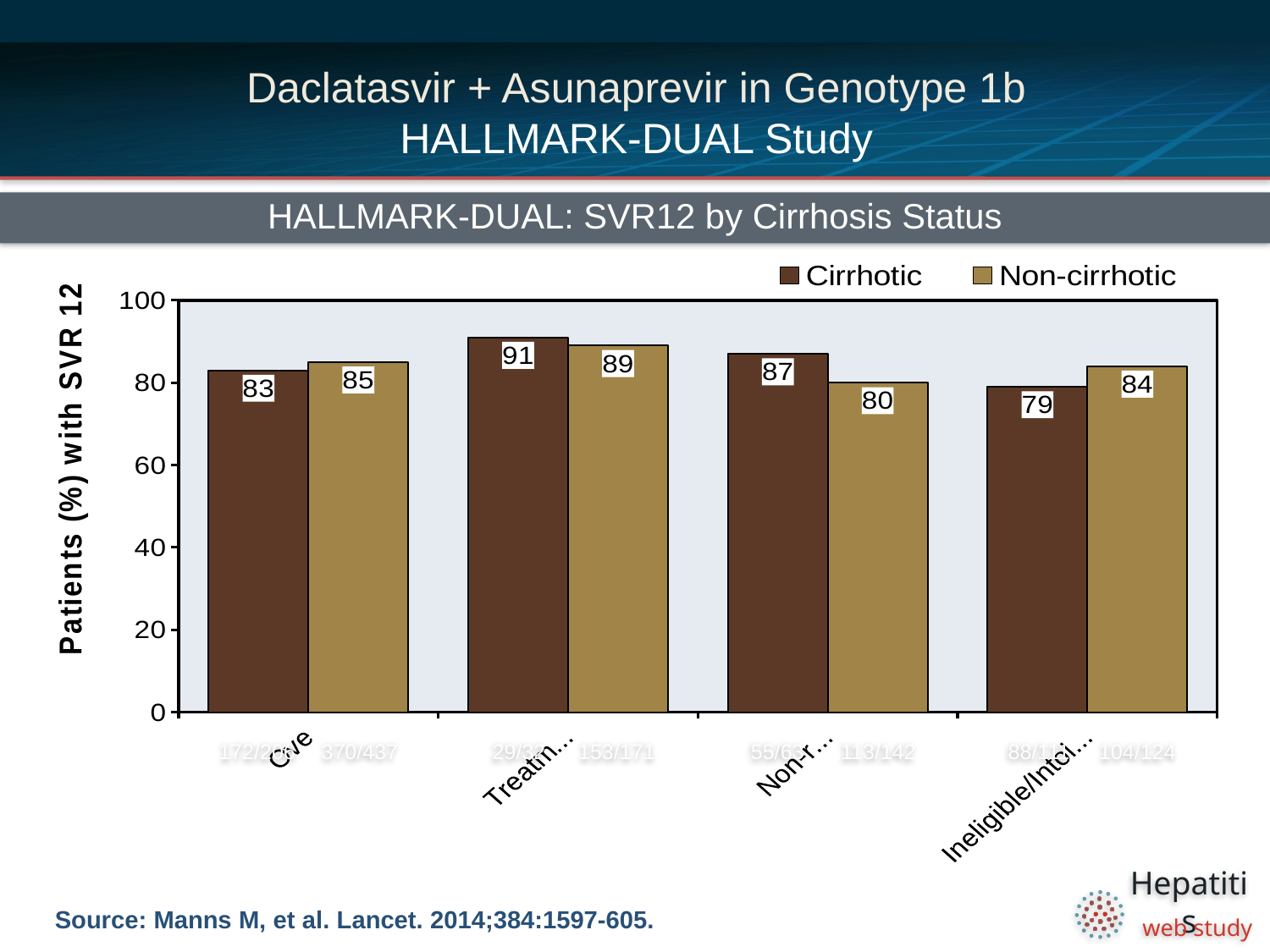
What kind of chart is shown on the slide? bar chart What is the Cirrhotic value in the second group of bars from the left? 91 In the fourth group of bars from the left, which series has the larger value, Cirrhotic or Non-cirrhotic? Non-cirrhotic In the third group of bars from the left, how much higher is the Cirrhotic value than the Non-cirrhotic value? 7 What is the lowest value among the Non-cirrhotic bars? 80 How many series does the legend list? 2 What is the highest value among the Cirrhotic bars? 91 How many category groups are plotted along the x axis? 4 Is the Cirrhotic value in the fourth group of bars from the left greater or less than 60? greater What is the Non-cirrhotic value in the third group of bars from the left? 80 In the first group of bars from the left, what is the difference between the Non-cirrhotic and Cirrhotic values? 2 What is the label on the y axis of the chart? Patients (%) with SVR 12